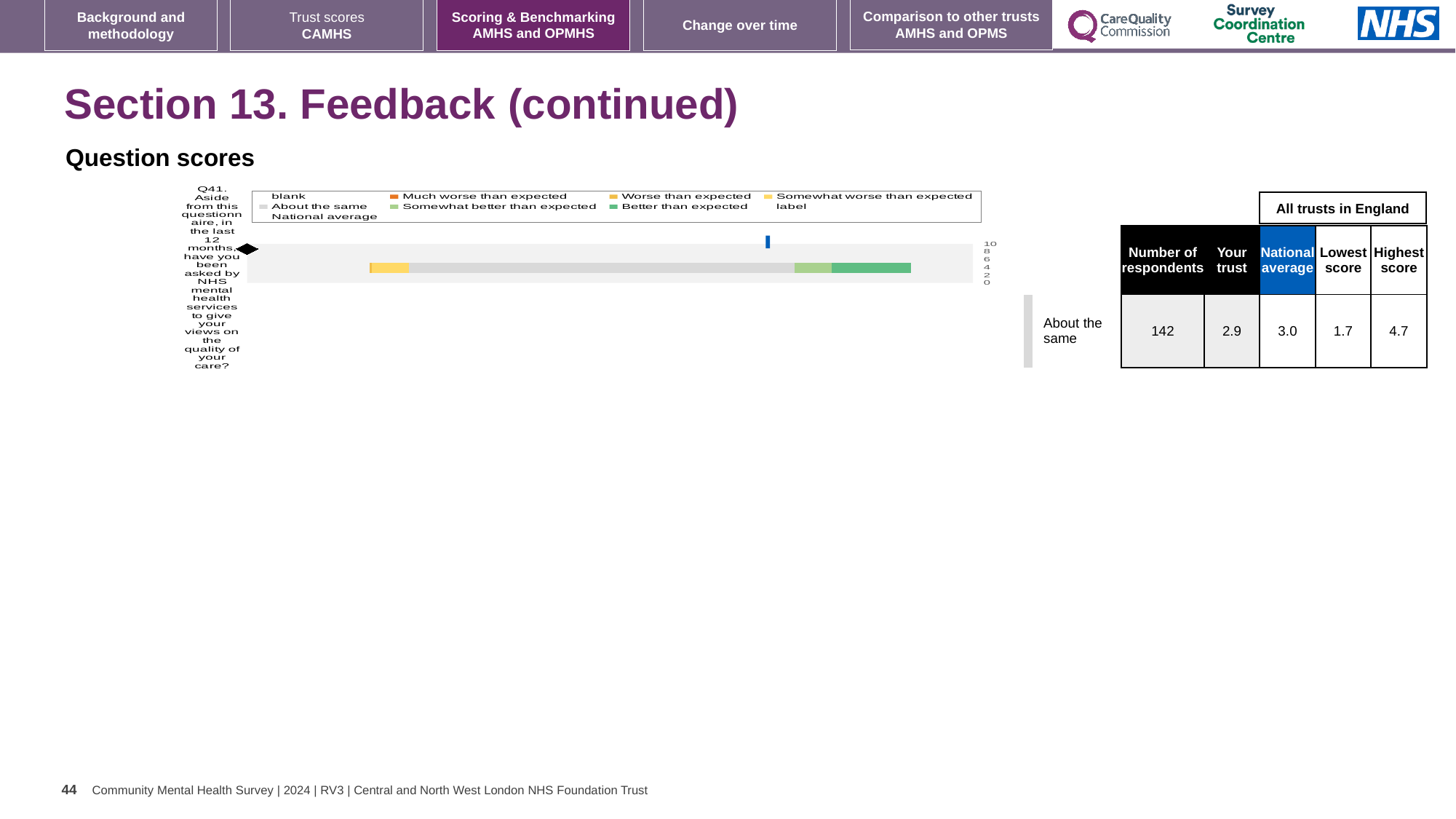
What benchmark category is the trust's result for Q41 labelled as? About the same What is the difference between the highest score and the lowest score for Q41 in the table beside the chart? 3.0 What colour is the 'Better than expected' segment in the chart's legend? green In the table beside the chart, what is the 'Your trust' score for Q41? 2.9 In the table beside the chart, what is the national average score for Q41? 3.0 Which question number is plotted in the chart? Q41 In the table beside the chart, what is the highest score among all trusts in England for Q41? 4.7 In the table beside the chart, what is the lowest score among all trusts in England for Q41? 1.7 Which is larger for Q41, the 'Your trust' score or the national average? National average What kind of chart is shown on the slide? bar chart How many survey questions are plotted in the chart? 1 In the table beside the chart, what is the number of respondents for Q41? 142